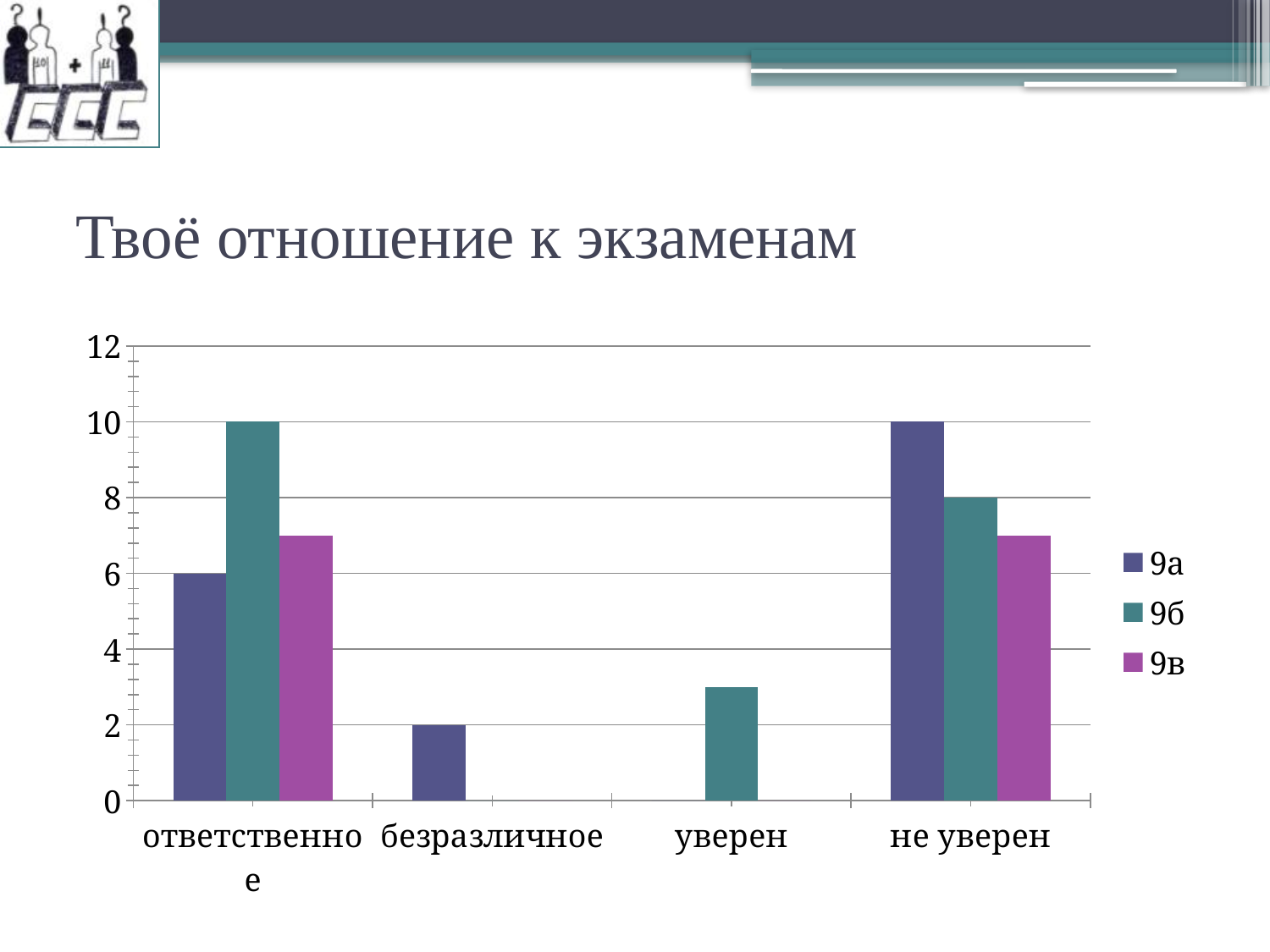
Is the value for 9в in the category ответственное greater or less than 6? greater What kind of chart is shown on the slide? bar chart How many categories are shown on the x axis? 4 What is the value for 9а in the category ответственное? 6 Which series has the highest value in the category ответственное? 9б What is the difference between the 9а and 9б values in the category не уверен? 2 How many series does the legend list? 3 What is the value for 9б in the category ответственное? 10 What is the value for 9а in the category безразличное? 2 Is the value for 9б in the category уверен greater or less than 4? less What is the value for 9б in the category не уверен? 8 What is the value for 9а in the category не уверен? 10